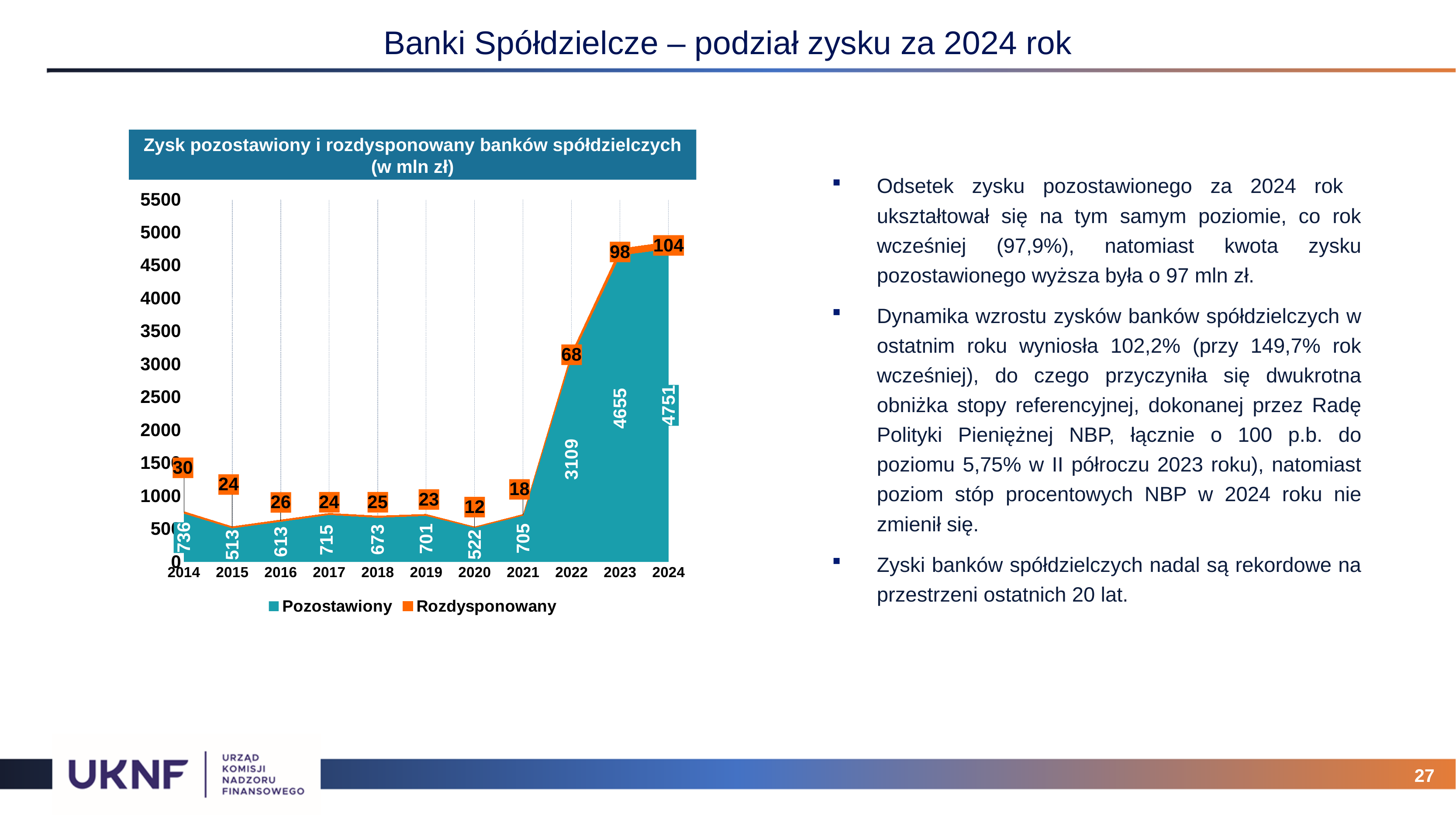
What is the title of the chart? Zysk pozostawiony i rozdysponowany banków spółdzielczych (w mln zł) What is the value of Rozdysponowany for 2020? 12 What is the total of Pozostawiony and Rozdysponowany for 2022? 3177 What kind of chart is shown? Stacked area chart How many series does the legend list? 2 What is the value of Pozostawiony for 2024? 4751 How many years are shown on the x axis? 11 Which year has the highest Pozostawiony value? 2024 What is the value of Pozostawiony for 2015? 513 Which is larger, the Pozostawiony value for 2014 or for 2021? 2014 What is the difference between the Pozostawiony values for 2024 and 2023? 96 Which year has the lowest Rozdysponowany value? 2020